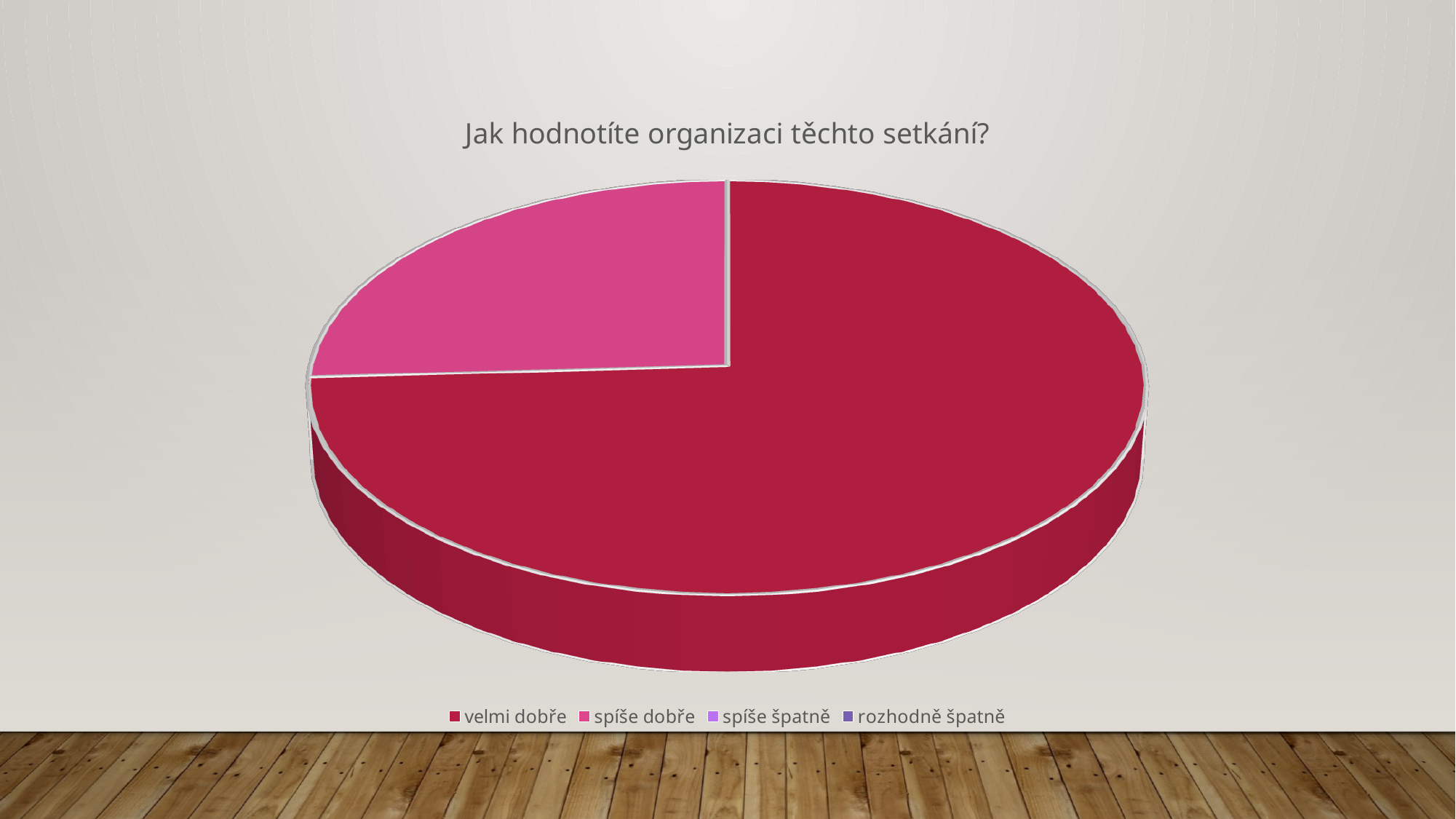
What is the title of the chart? Jak hodnotíte organizaci těchto setkání? How many slices are visible in the pie? 2 How many entries does the chart's legend list? 4 What kind of chart is shown on the slide? pie chart Which is larger, the slice for velmi dobře or the slice for spíše dobře? velmi dobře Which category has the largest slice of the pie? velmi dobře Does the slice for velmi dobře take up more or less than half of the pie? more Which legend entry is shown in the dark red colour? velmi dobře